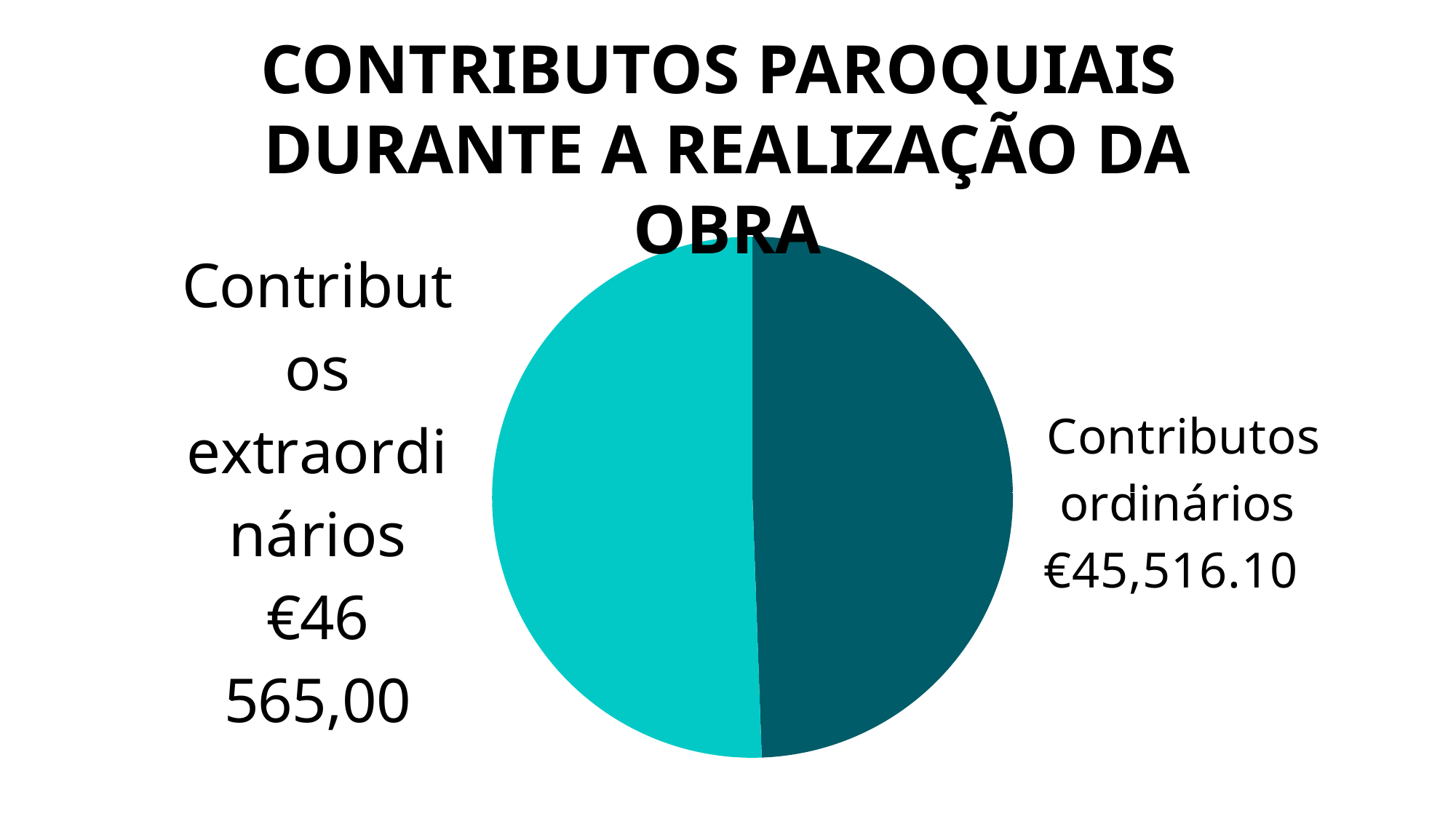
What is the total of the two values shown in the pie chart? €92,081.10 How many slices does the pie chart have? 2 What is the value shown for Contributos extraordinários? €46 565,00 What is the difference between the Contributos extraordinários value and the Contributos ordinários value? €1,048.90 What kind of chart is shown on the slide? pie chart Which slice is drawn in the darker teal colour? Contributos ordinários Which slice has the larger value, Contributos ordinários or Contributos extraordinários? Contributos extraordinários What share of the total do Contributos ordinários represent? 49.4% What is the value shown for Contributos ordinários? €45,516.10 What is the title of the chart? CONTRIBUTOS PAROQUIAIS DURANTE A REALIZAÇÃO DA OBRA